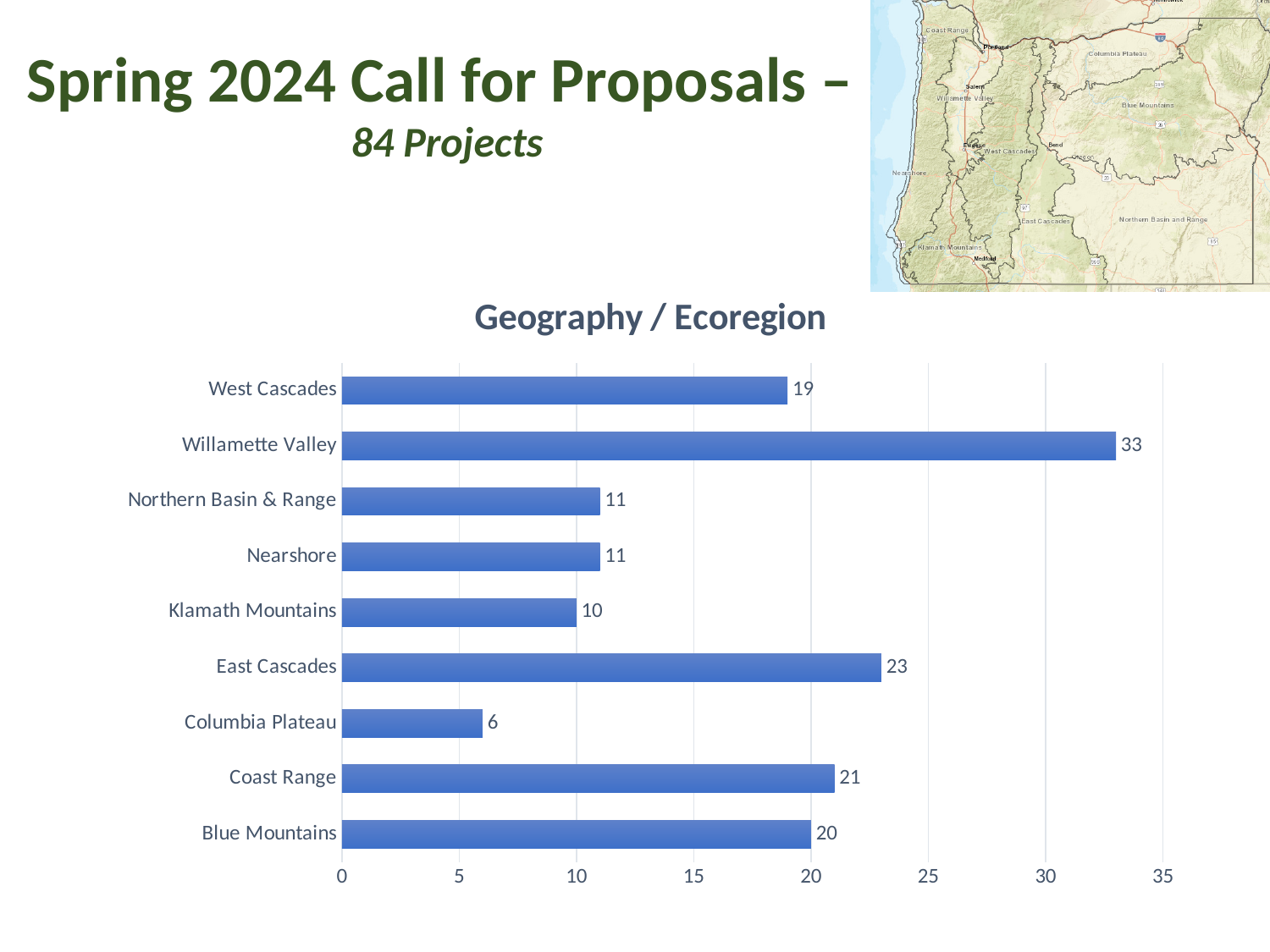
What kind of chart is shown on the slide? bar chart Which is larger, the value for Coast Range or the value for Blue Mountains? Coast Range What is the value for Willamette Valley? 33 What is the title of the chart? Geography / Ecoregion What is the difference between the values for Willamette Valley and East Cascades? 10 Is the value for West Cascades greater or less than 20? less Which category has the highest value? Willamette Valley What is the difference between the values for Klamath Mountains and Columbia Plateau? 4 Which category has the lowest value? Columbia Plateau How many categories are shown in the chart? 9 What is the value for Columbia Plateau? 6 What is the value for East Cascades? 23